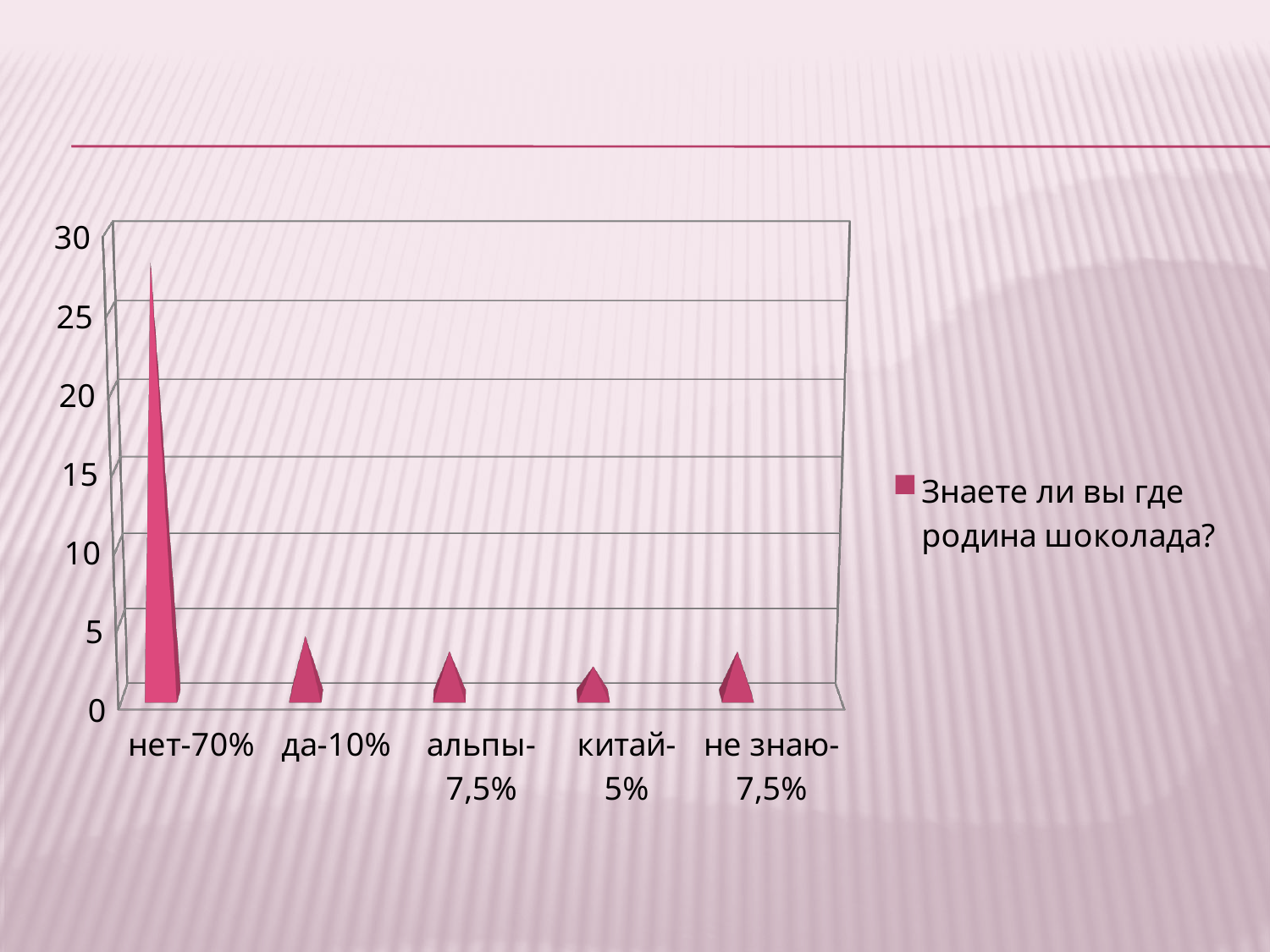
Which is larger, the value for нет-70% or the value for да-10%? нет-70% Is the value for нет-70% greater or less than 25? greater Which category has the highest bar in the chart? нет-70% What is the series name shown in the chart's legend? Знаете ли вы где родина шоколада? Which is larger, the value for да-10% or the value for китай-5%? да-10% What kind of chart is shown on the slide? bar chart Is the value for китай-5% greater or less than 5? less Which category has the lowest bar in the chart? китай-5% Is the value for да-10% greater or less than 5? less How many series does the chart's legend list? 1 What is the highest value shown on the chart's vertical axis? 30 How many categories are shown on the x axis of the chart? 5